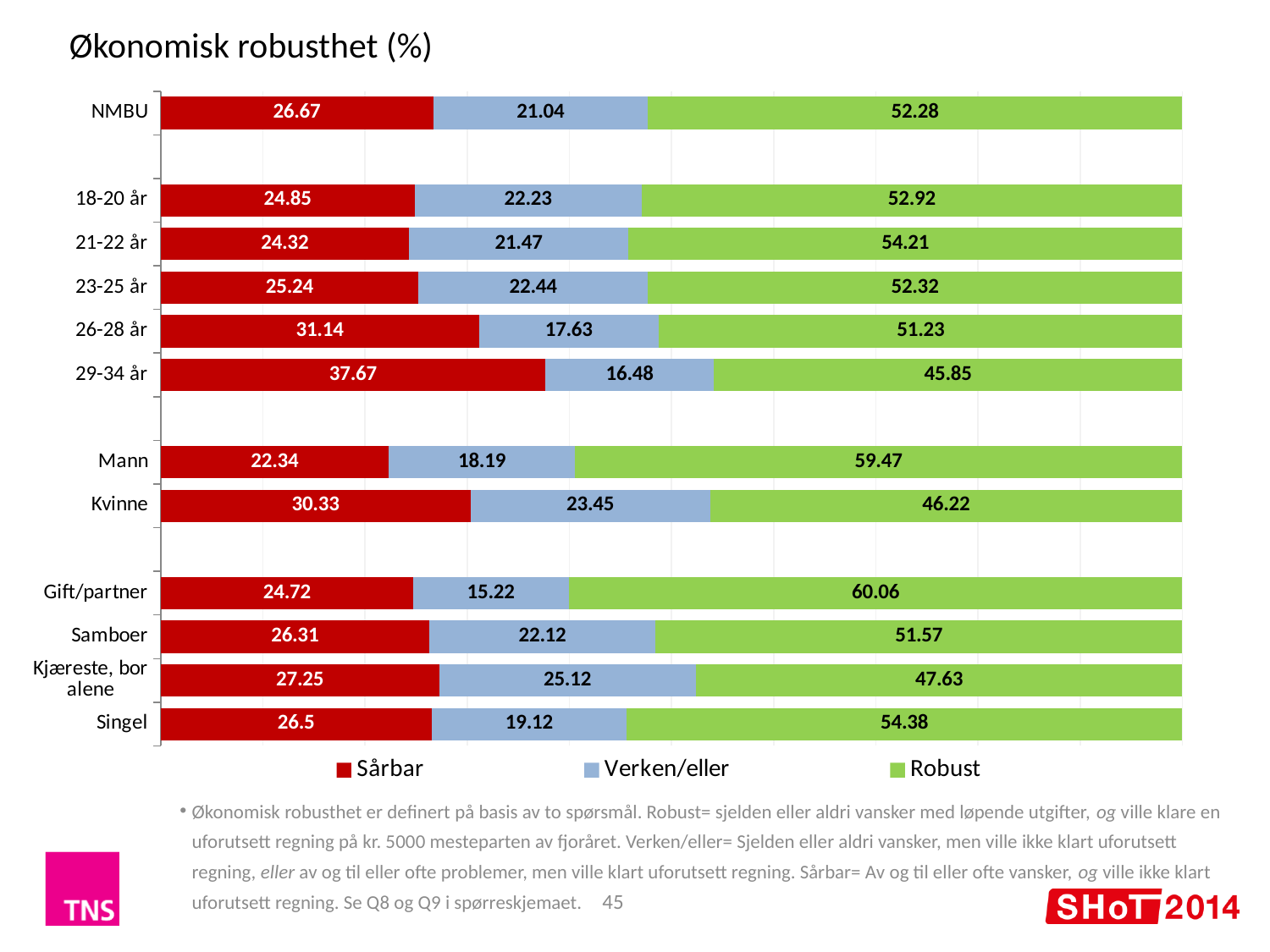
Which category has the lowest Robust value? 29-34 år What is the difference between the Robust values for Mann and Kvinne? 13.25 What kind of chart is shown on the slide? Stacked bar chart Which category has the highest Robust value? Gift/partner Which category has the highest Sårbar value? 29-34 år Which category has the lowest Verken/eller value? Gift/partner What is the Sårbar value for NMBU? 26.67 What is the Verken/eller value for Kjæreste, bor alene? 25.12 What is the Robust value for Mann? 59.47 How many series does the legend list? 3 Which has a larger Sårbar value, Kvinne or Mann? Kvinne How many categories are shown on the chart? 12